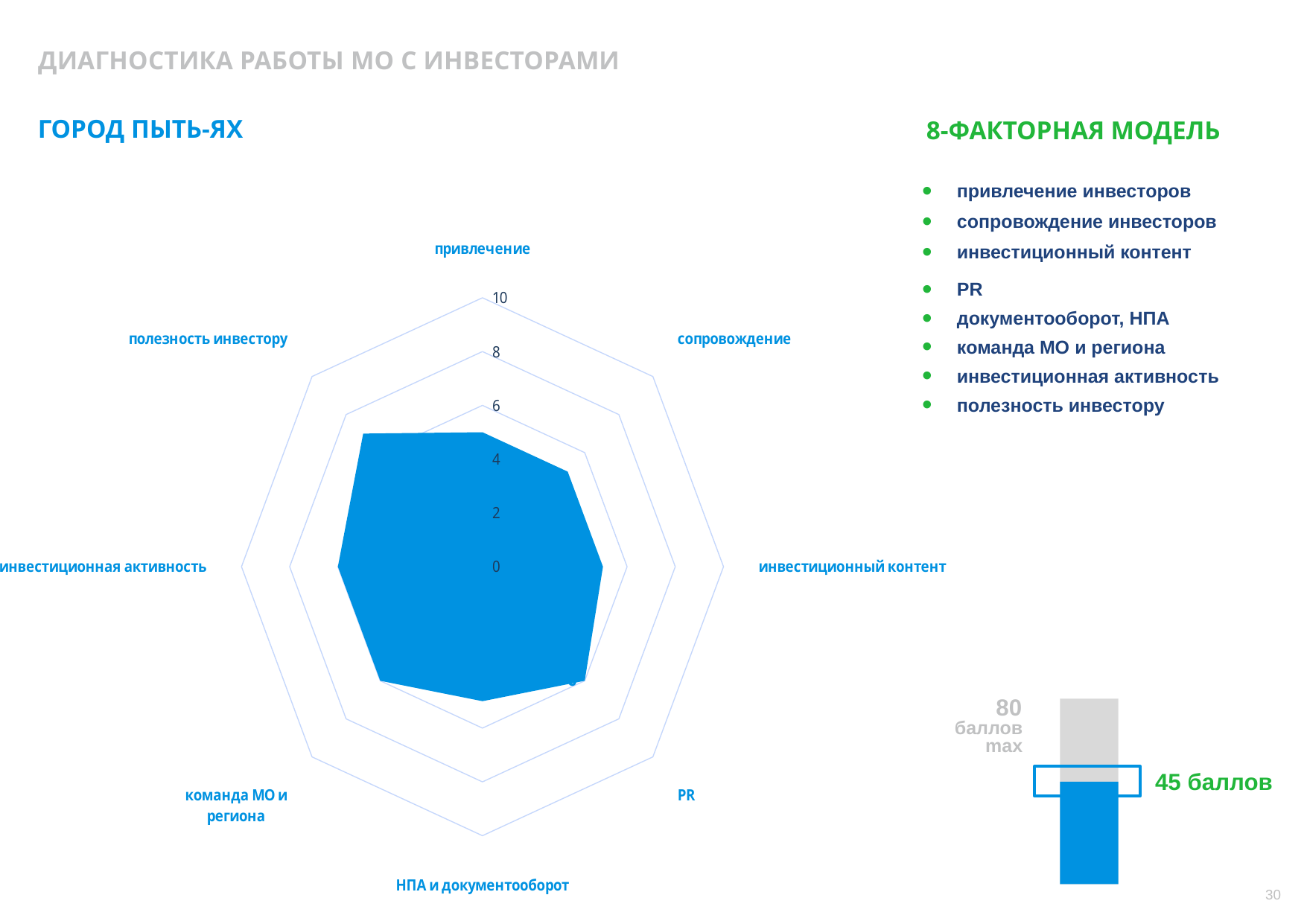
On the radar chart, is the value for сопровождение greater or less than 8? less What is the highest value shown on the radar chart's scale? 10 What score is shown on the bar chart at the bottom right of the slide? 45 баллов How many factors (axes) does the radar chart on the left have? 8 On the radar chart, is the value for инвестиционный контент greater or less than 6? less On the radar chart, is the value for полезность инвестору greater or less than 6? greater On the radar chart, which is larger: the value for полезность инвестору or the value for инвестиционный контент? полезность инвестору What is the maximum score shown on the bar chart at the bottom right of the slide? 80 баллов What kind of chart is the large chart on the left of the slide? radar chart On the radar chart, which factor has the highest value? полезность инвестору